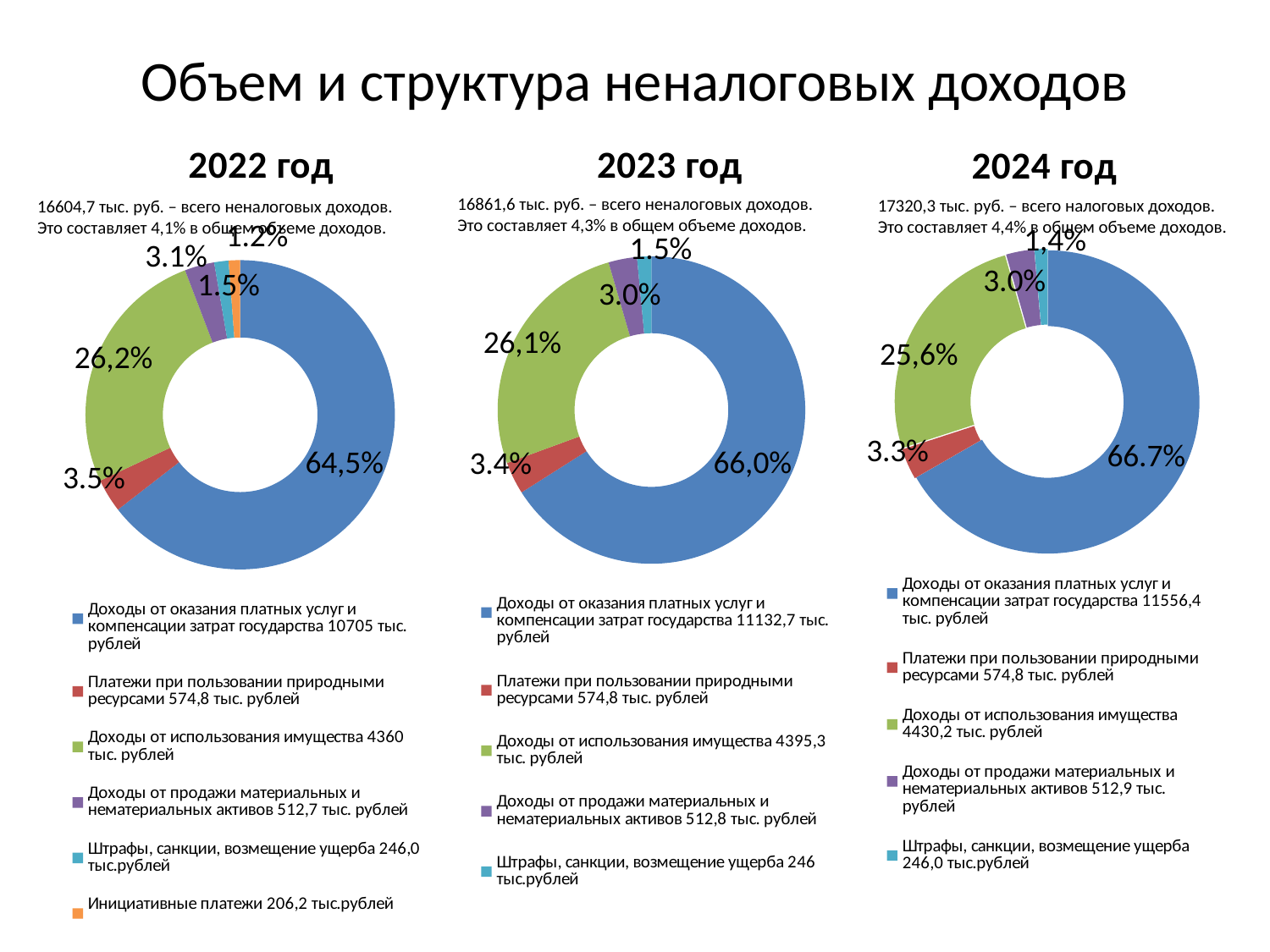
In the 2024 год chart, what is the difference between the share for Доходы от оказания платных услуг и компенсации затрат государства (66.7%) and the share for Доходы от использования имущества (25,6%)? 41.1% In the 2022 год chart, how many categories does the legend list? 6 According to the legend of the 2024 год chart, what is the value for Доходы от использования имущества? 4430,2 тыс. рублей In the 2022 год chart, which category has the smallest share? Инициативные платежи In the 2023 год chart, how many categories does the legend list? 5 According to the text above the 2022 год chart, what is the total of non-tax revenues? 16604,7 тыс. руб. In the 2022 год chart, what share is labelled for Доходы от оказания платных услуг и компенсации затрат государства? 64,5% What kind of chart is used for the 2022 год data? Donut (pie) chart In the 2023 год chart, which is larger: the share for Платежи при пользовании природными ресурсами or the share for Доходы от продажи материальных и нематериальных активов? Платежи при пользовании природными ресурсами In the 2023 год chart, what share is labelled for Доходы от использования имущества? 26,1% In the 2024 год chart, what share is labelled for Платежи при пользовании природными ресурсами? 3.3% In the 2024 год chart, which category has the largest share? Доходы от оказания платных услуг и компенсации затрат государства